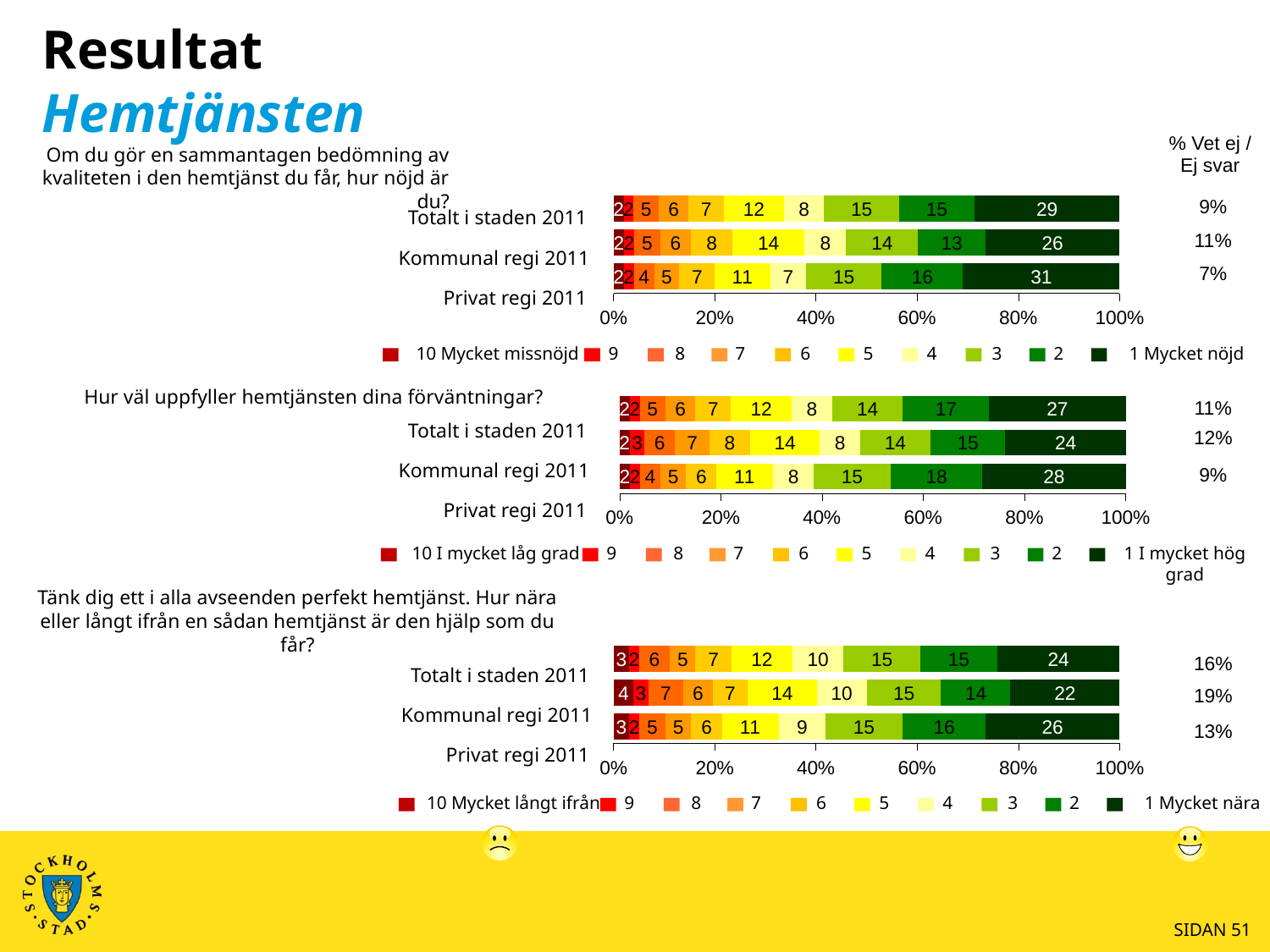
In the bottom chart, what is the value of the '10 Mycket långt ifrån' segment for Kommunal regi 2011? 4 What type of chart is used for the middle chart? Stacked bar chart In the top chart (Om du gör en sammantagen bedömning...), what is the value of the '1 Mycket nöjd' segment for Privat regi 2011? 31 In the bottom chart (Tänk dig ett i alla avseenden perfekt hemtjänst...), what is the value of the '1 Mycket nära' segment for Privat regi 2011? 26 In the middle chart, which category has the smallest '1 I mycket hög grad' segment? Kommunal regi 2011 In the top chart, which category has the largest '1 Mycket nöjd' segment? Privat regi 2011 In the top chart, what is the difference between the '1 Mycket nöjd' values for Privat regi 2011 and Kommunal regi 2011? 5 How many series does the legend of the top chart list? 10 In the top chart, what is the value of the '5' segment for Kommunal regi 2011? 14 How many categories (rows) are shown in the bottom chart? 3 In the middle chart (Hur väl uppfyller hemtjänsten dina förväntningar?), which is larger for the '1 I mycket hög grad' segment: Totalt i staden 2011 or Kommunal regi 2011? Totalt i staden 2011 In the middle chart, what is the value of the '2' segment for Privat regi 2011? 18